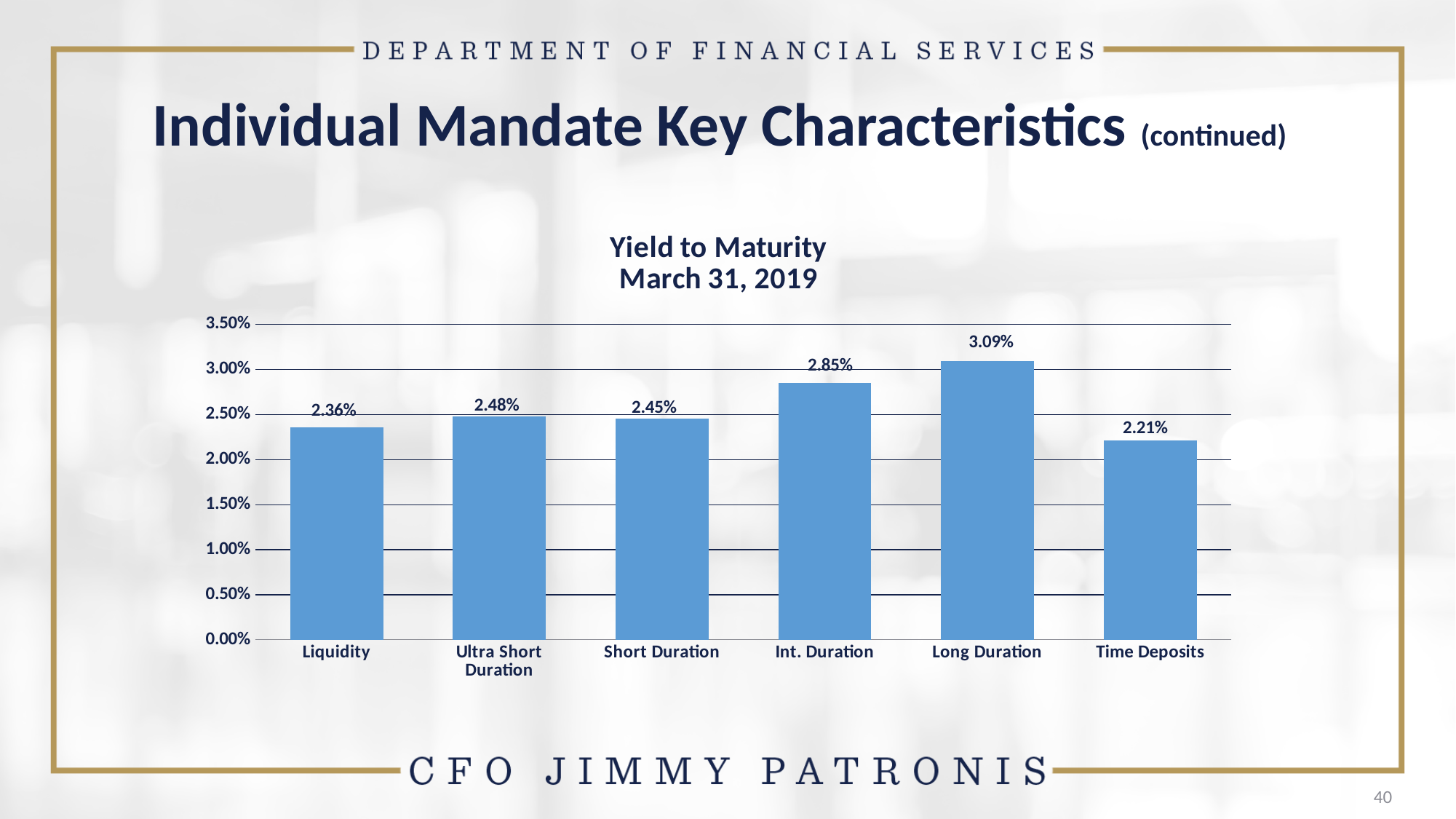
What is the yield to maturity for Liquidity? 2.36% What is the title of the chart? Yield to Maturity March 31, 2019 Which category has the lowest yield to maturity? Time Deposits What kind of chart is shown on the slide? Bar chart Which has a higher yield to maturity, Ultra Short Duration or Short Duration? Ultra Short Duration What is the yield to maturity for Int. Duration? 2.85% Is the yield to maturity for Int. Duration greater or less than 2.50%? greater What is the yield to maturity for Long Duration? 3.09% How many categories are shown in the chart? 6 What is the yield to maturity for Time Deposits? 2.21% What is the difference between the yield to maturity for Long Duration and Int. Duration? 0.24% Which category has the highest yield to maturity? Long Duration